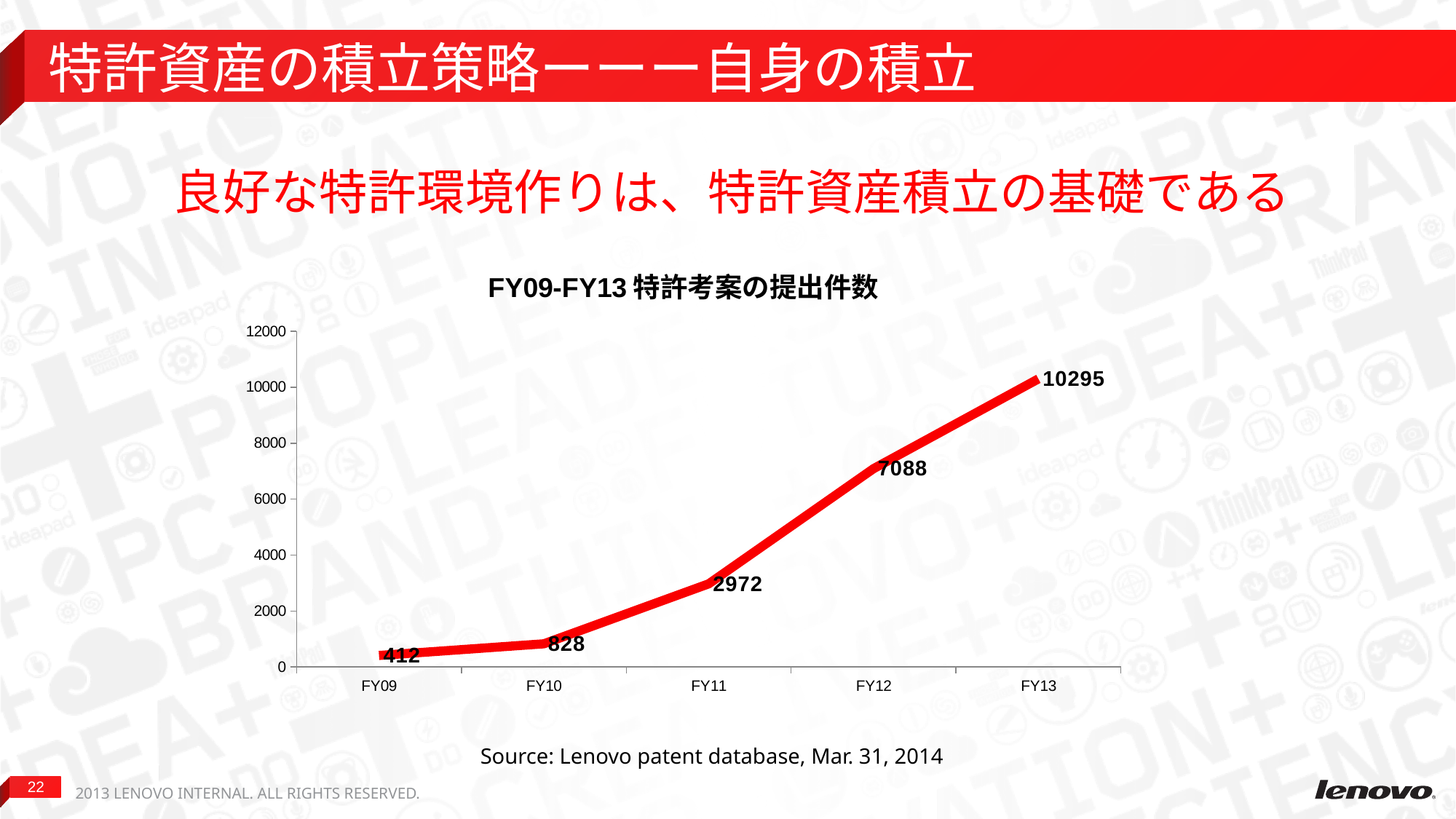
What kind of chart is shown on the slide? line chart How many fiscal years are plotted on the x axis? 5 What is the difference between the FY13 and FY12 values? 3207 Is the value for FY12 greater or less than 6000? greater What is the difference between the FY10 and FY09 values? 416 What is the value for FY11? 2972 What is the value for FY09? 412 What is the value for FY13? 10295 Which fiscal year has the lowest value? FY09 Do the values rise or fall from FY09 to FY13? rise Which fiscal year has the highest value? FY13 Which is larger, the value for FY11 or the value for FY12? FY12